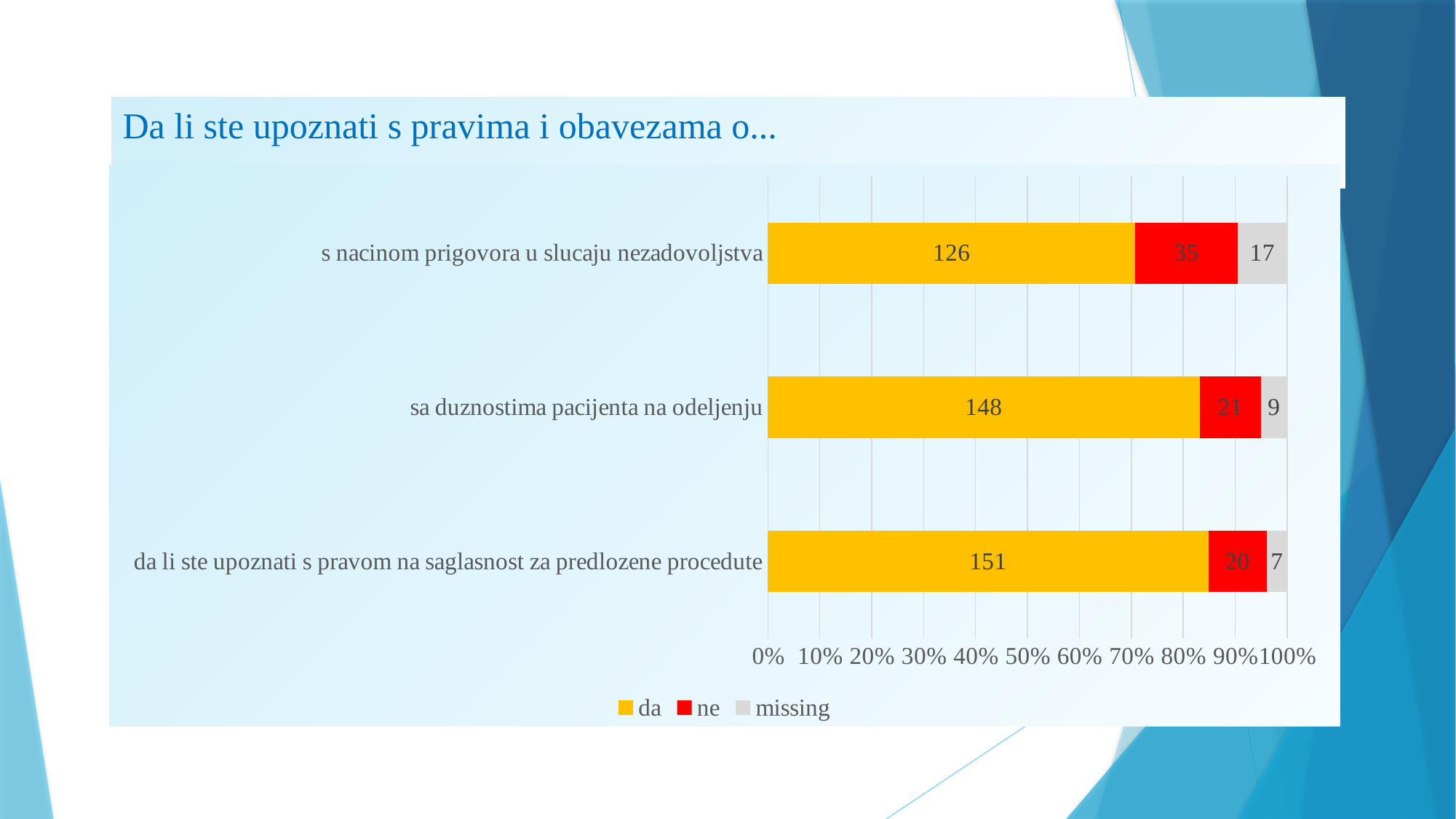
What colour represents the 'ne' series? red What is the 'missing' value for 'da li ste upoznati s pravom na saglasnost za predlozene procedute'? 7 Which category has the highest 'da' value? da li ste upoznati s pravom na saglasnost za predlozene procedute What is the difference between the 'da' values for 'sa duznostima pacijenta na odeljenju' and 's nacinom prigovora u slucaju nezadovoljstva'? 22 What is the 'da' value for 's nacinom prigovora u slucaju nezadovoljstva'? 126 Which category has the lowest 'missing' value? da li ste upoznati s pravom na saglasnost za predlozene procedute Which is larger: the 'ne' value for 's nacinom prigovora u slucaju nezadovoljstva' or for 'sa duznostima pacijenta na odeljenju'? s nacinom prigovora u slucaju nezadovoljstva What is the total of the stacked bar for 's nacinom prigovora u slucaju nezadovoljstva'? 178 How many categories are shown on the chart? 3 How many series does the legend list? 3 What kind of chart is shown on the slide? stacked bar chart What is the 'ne' value for 'sa duznostima pacijenta na odeljenju'? 21